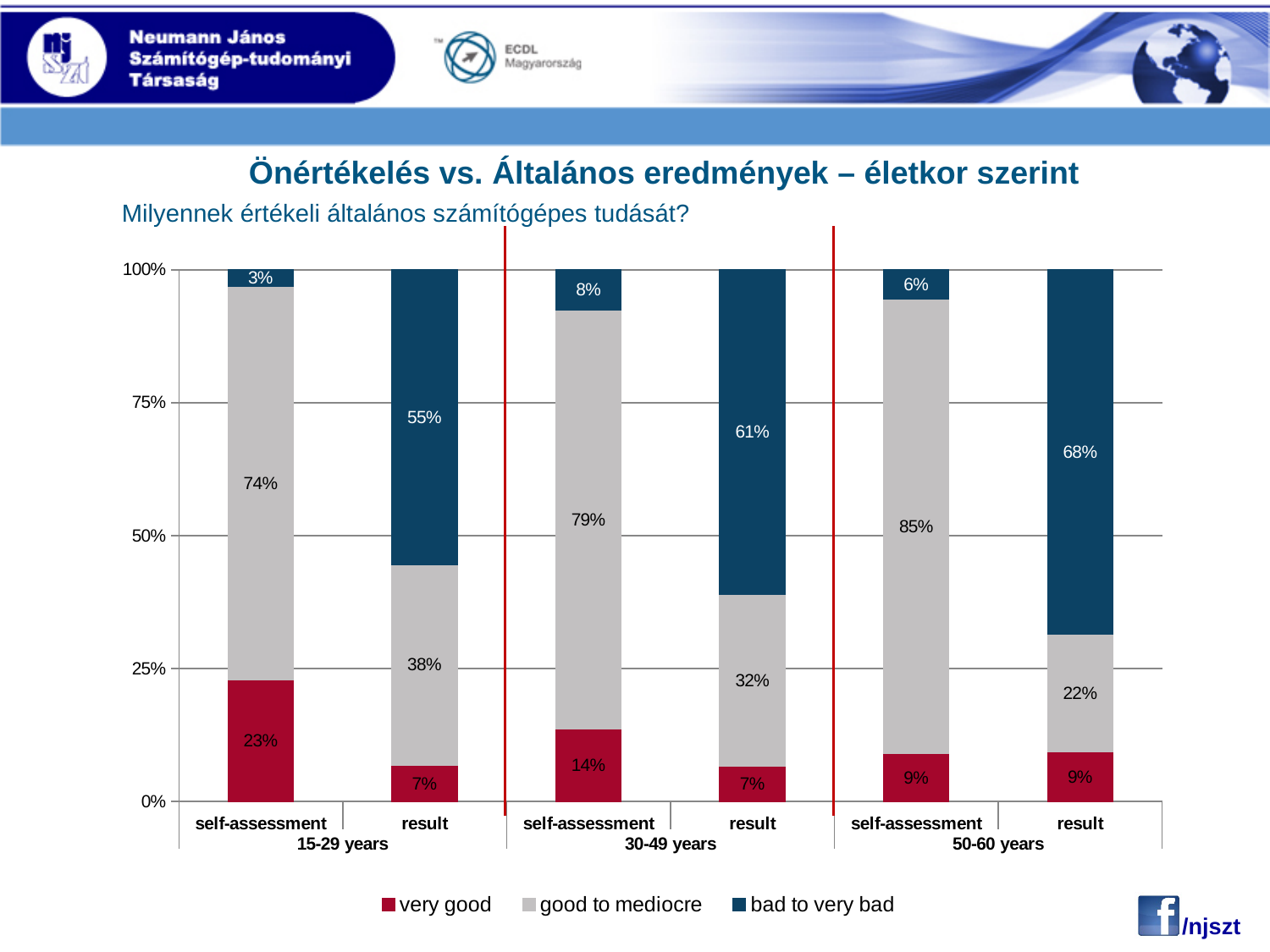
What is the 'good to mediocre' value for self-assessment in the 30-49 years group? 79% Which colour represents the 'very good' series in the legend? red Which bar has the lowest 'bad to very bad' value? self-assessment, 15-29 years What is the 'bad to very bad' value for result in the 50-60 years group? 68% What is the 'very good' value for self-assessment in the 15-29 years group? 23% How many bars are plotted in the chart? 6 How many series does the legend list? 3 Which is larger: the 'very good' value for self-assessment in the 15-29 years group or in the 30-49 years group? 15-29 years What kind of chart is shown on the slide? stacked bar chart What is the difference between the 'bad to very bad' value for result and for self-assessment in the 30-49 years group? 53% Does the 'bad to very bad' value for result rise or fall across the age groups from 15-29 to 50-60 years? rises Which bar has the highest 'good to mediocre' value? self-assessment, 50-60 years